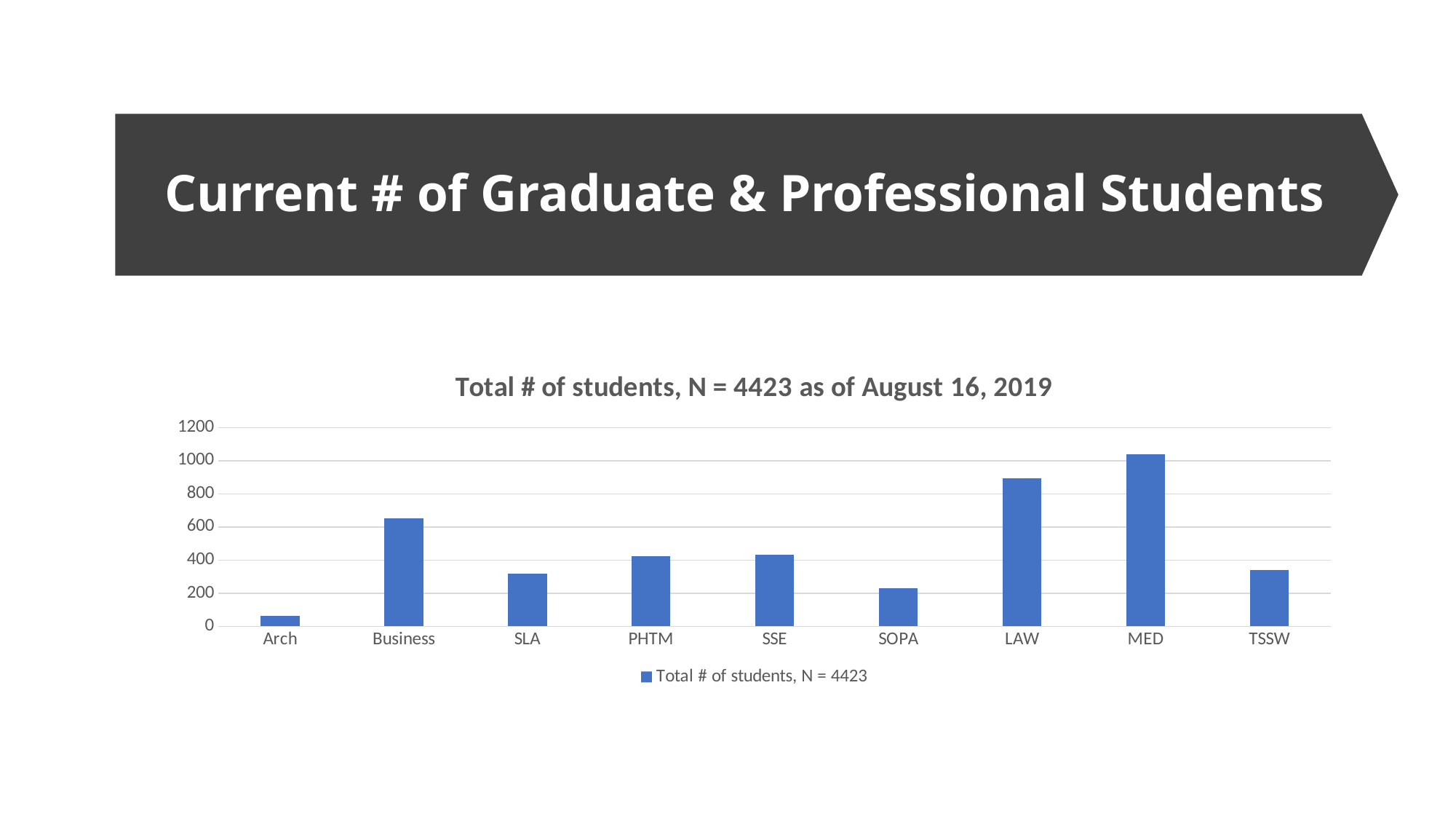
Is the value for Arch greater or less than 200? less Which category has the lowest number of students? Arch Which is larger, the value for Business or the value for SLA? Business Is the value for SOPA greater or less than 400? less Is the value for MED greater or less than 1000? greater How many series does the legend list? 1 Which category has the highest number of students? MED How many categories are shown on the x axis? 9 What kind of chart is shown on the slide? bar chart Which is larger, the value for LAW or the value for MED? MED What is the title of the chart? Total # of students, N = 4423 as of August 16, 2019